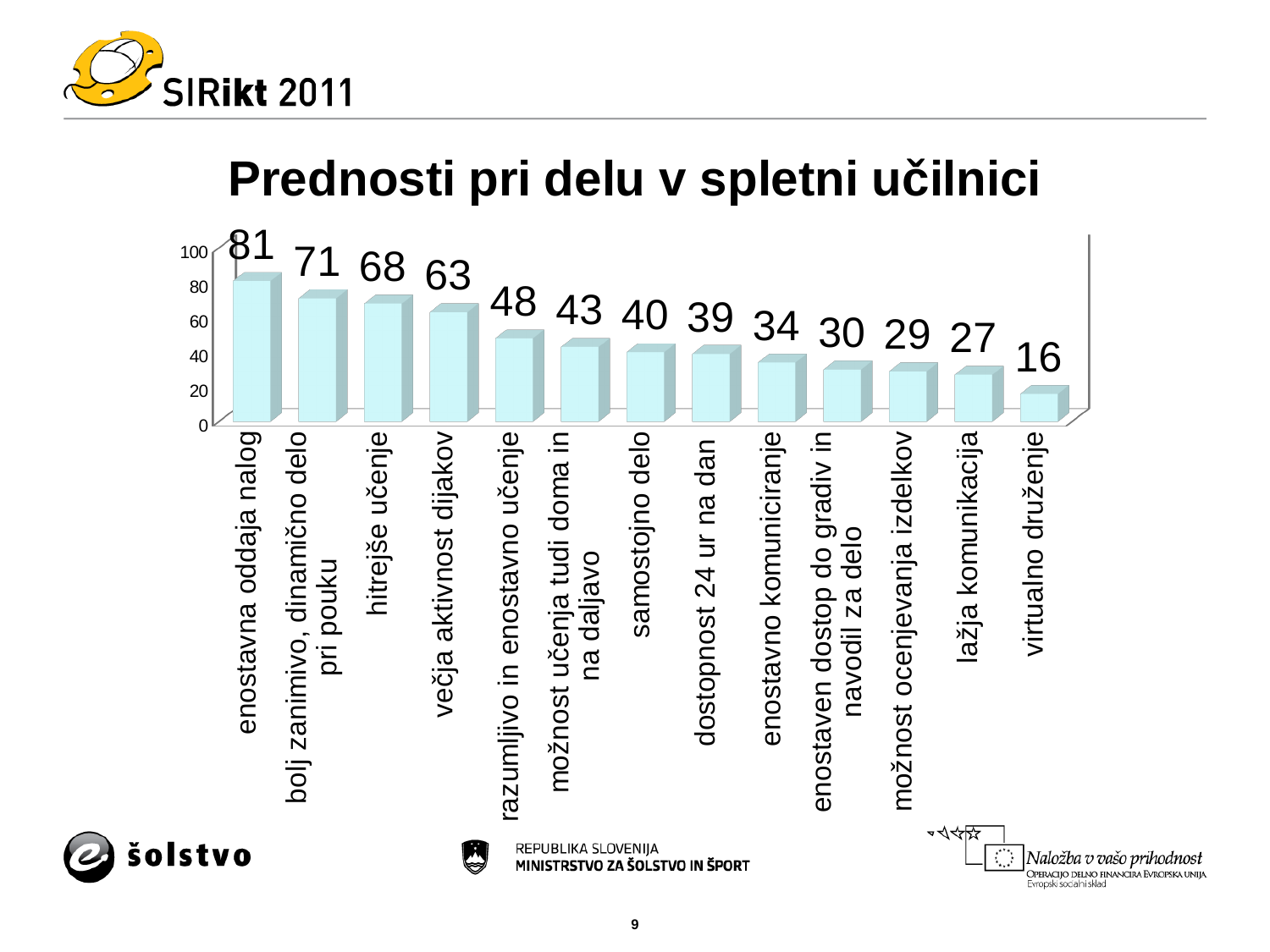
Which category has the lowest value? virtualno druženje What is the difference between the values for "enostavna oddaja nalog" and "virtualno druženje"? 65 What is the value for "enostavna oddaja nalog"? 81 How many categories are shown in the chart? 13 What is the value for "dostopnost 24 ur na dan"? 39 What is the title of the chart? Prednosti pri delu v spletni učilnici What kind of chart is shown on the slide? bar chart What is the value for "lažja komunikacija"? 27 What is the difference between the values for "bolj zanimivo, dinamično delo pri pouku" and "večja aktivnost dijakov"? 8 What is the value for "hitrejše učenje"? 68 Which category has the highest value? enostavna oddaja nalog Which is larger, the value for "samostojno delo" or the value for "enostavno komuniciranje"? samostojno delo